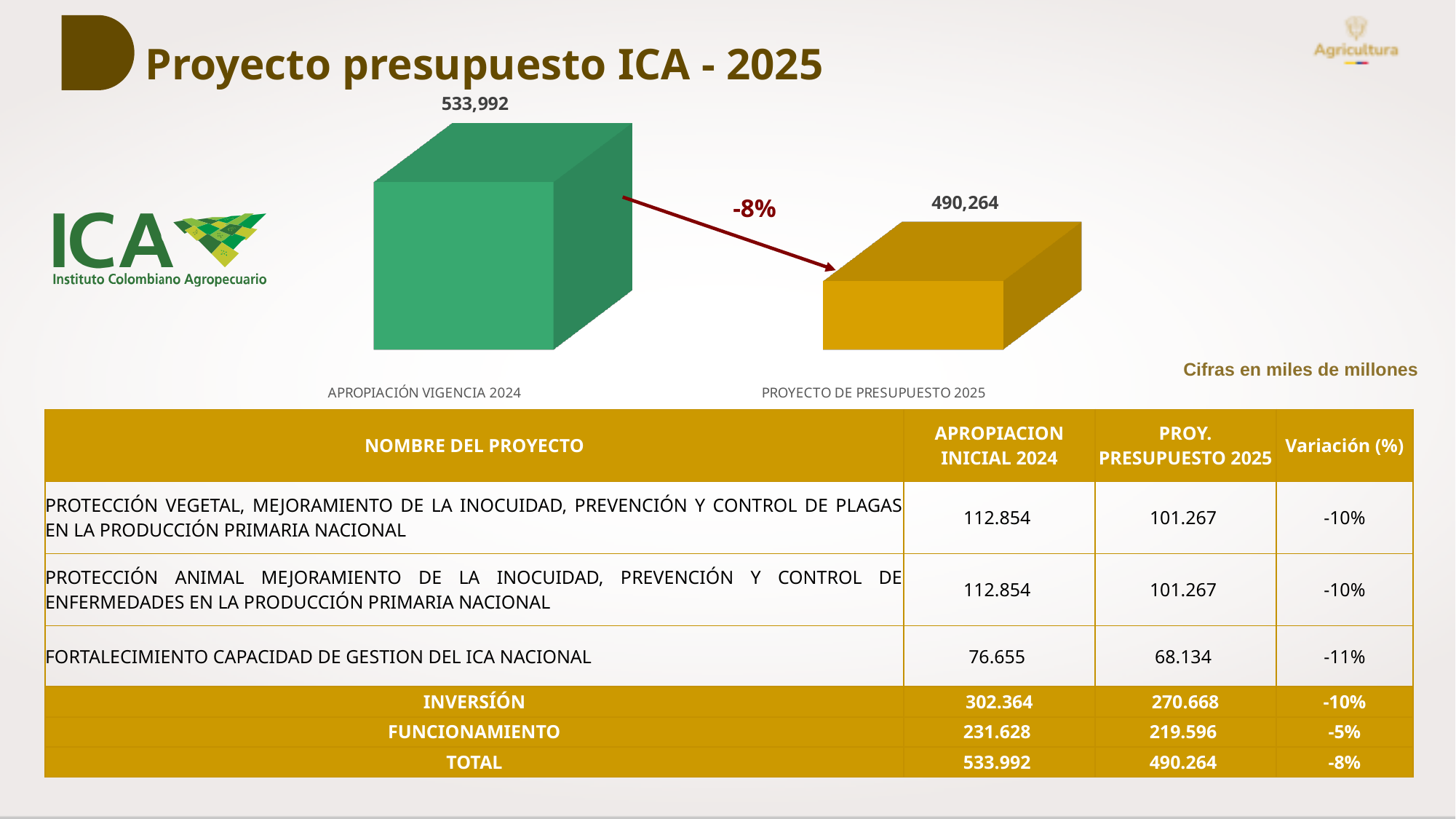
Which category has the higher value in the chart? APROPIACIÓN VIGENCIA 2024 Which category has the lower value in the chart? PROYECTO DE PRESUPUESTO 2025 Is the value for APROPIACIÓN VIGENCIA 2024 larger or smaller than the value for PROYECTO DE PRESUPUESTO 2025? larger What is the value shown for APROPIACIÓN VIGENCIA 2024? 533,992 What kind of chart is shown on the slide? bar chart What colour is the bar for PROYECTO DE PRESUPUESTO 2025? yellow/gold Do the values rise or fall from APROPIACIÓN VIGENCIA 2024 to PROYECTO DE PRESUPUESTO 2025? fall What is the difference between the value for APROPIACIÓN VIGENCIA 2024 and the value for PROYECTO DE PRESUPUESTO 2025? 43,728 How many categories are plotted in the chart? 2 What percentage change is written on the arrow between the two bars? -8% What is the value shown for PROYECTO DE PRESUPUESTO 2025? 490,264